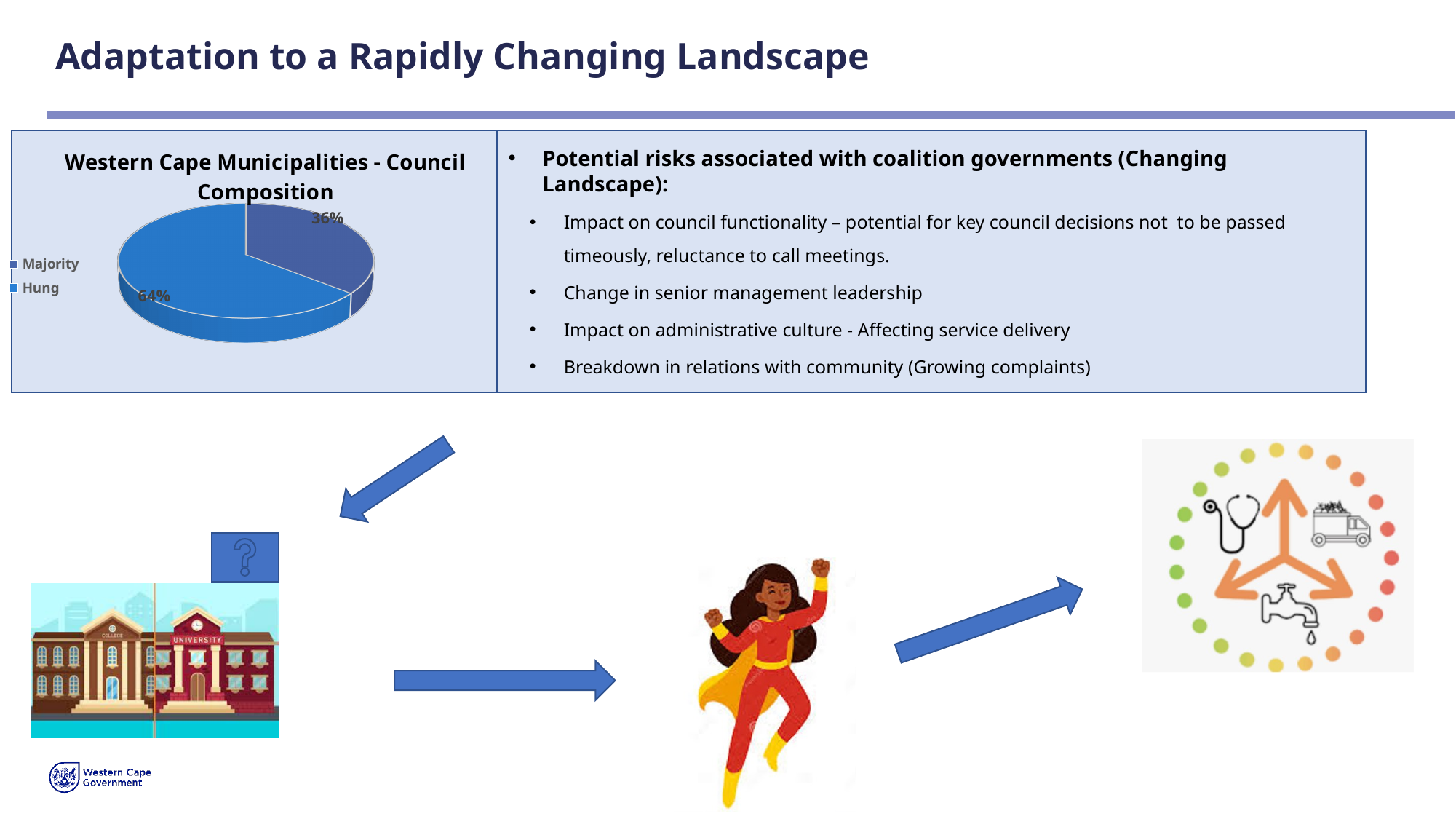
What is the difference in percentage points between the Majority and Hung slices? 28 Which category has the largest share of the pie chart? Hung How many categories does the pie chart show? 2 Which legend entry is listed first in the chart legend? Majority Which category has the smallest share of the pie chart? Majority What percentage of the pie chart is labelled for Hung councils? 64% Which is larger, the Majority slice or the Hung slice? Hung What share of the pie does the Hung slice represent? 64% What is the title of the chart on the slide? Western Cape Municipalities - Council Composition How many entries does the chart legend list? 2 What kind of chart is shown on the slide? Pie chart What percentage of the pie chart is labelled for Majority councils? 36%